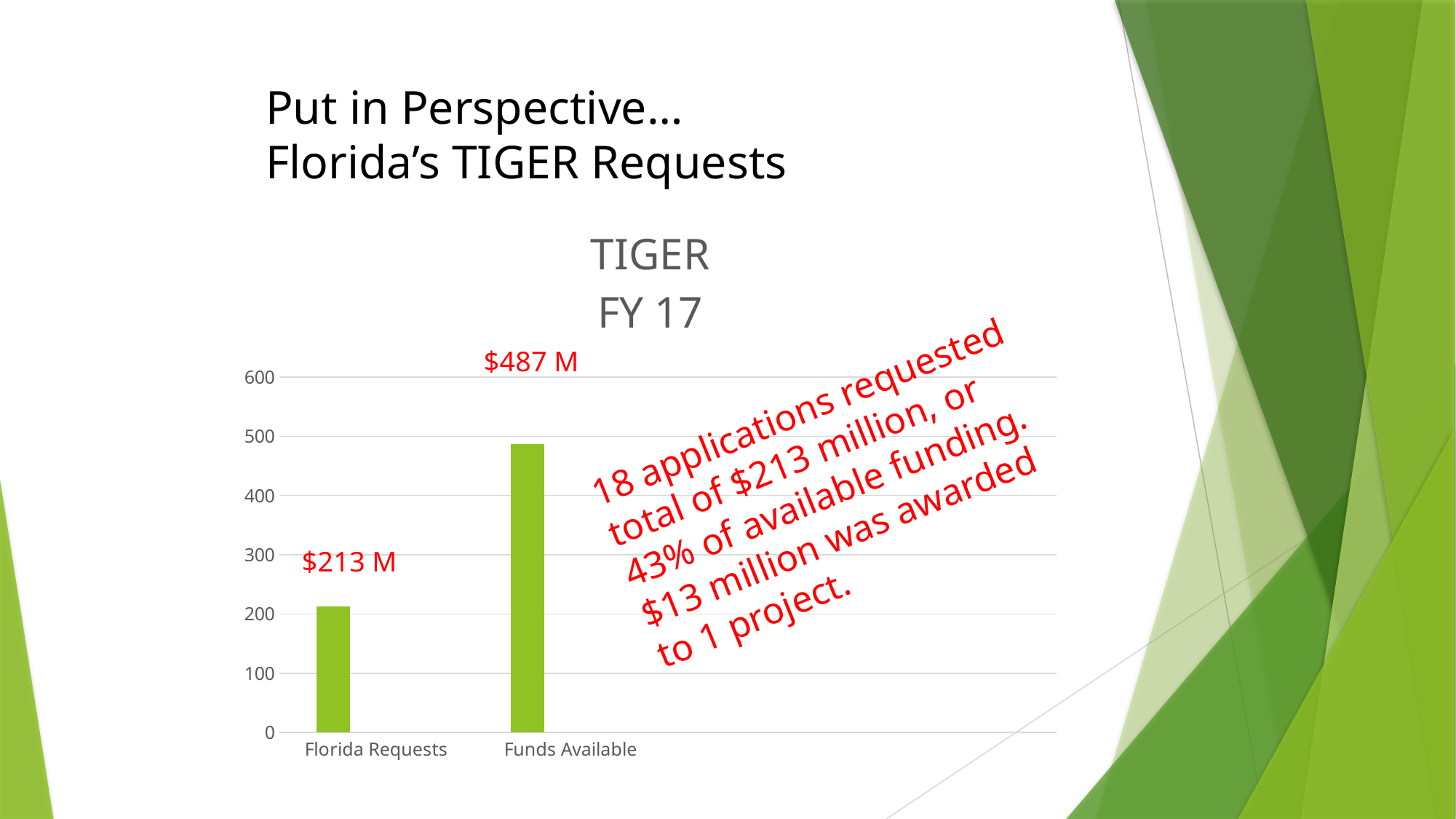
Which category has the highest value? Funds Available What is the highest tick value shown on the y axis? 600 Is the value for Florida Requests greater or less than 300? less What is the title of the chart? TIGER FY 17 What kind of chart is shown? bar chart What is the value for Funds Available? $487 M Which category has the lowest value? Florida Requests How many categories are shown on the x axis? 2 Which is larger, Florida Requests or Funds Available? Funds Available Is the value for Funds Available greater or less than 400? greater What is the difference between Funds Available and Florida Requests? $274 M What is the value for Florida Requests? $213 M